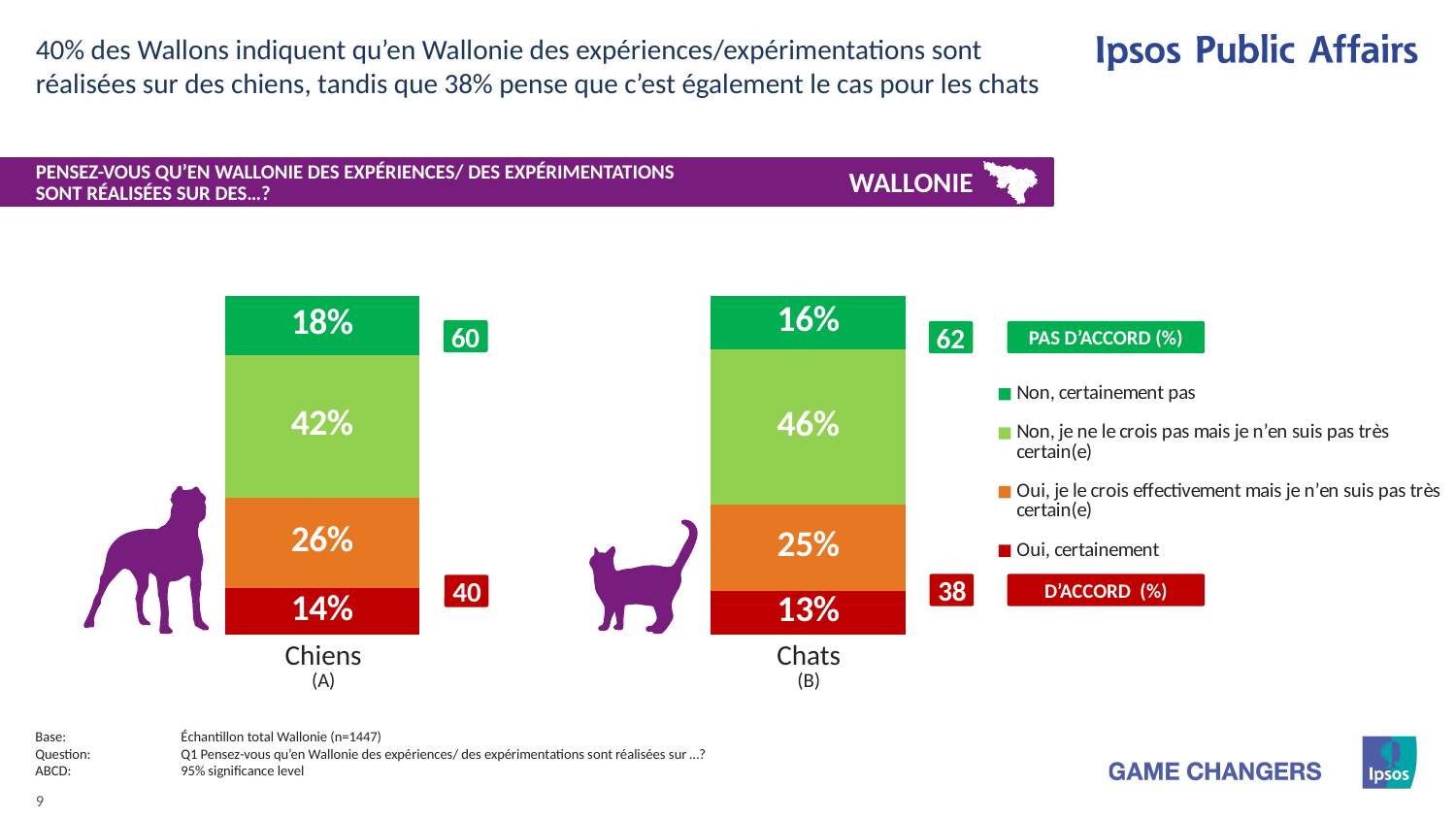
What is the "D'ACCORD (%)" total shown for Chiens? 40 What type of chart is shown on the slide? Stacked bar chart What is the difference between the "Oui, certainement" values for Chiens and Chats? 1% What is the value of the "Non, je ne le crois pas mais je n'en suis pas très certain(e)" segment for Chats? 46% How many series does the legend list? 4 What is the value of the "Oui, je le crois effectivement mais je n'en suis pas très certain(e)" segment for Chiens? 26% What is the "PAS D'ACCORD (%)" total shown for Chats? 62 Which category has the larger "Non, je ne le crois pas mais je n'en suis pas très certain(e)" segment, Chiens or Chats? Chats What percentage of respondents answered "Non, certainement pas" for Chats? 16% What is the combined share of the two "Oui" segments for Chats? 38% How many categories are shown on the x axis of the chart? 2 What percentage of respondents answered "Oui, certainement" for Chiens? 14%